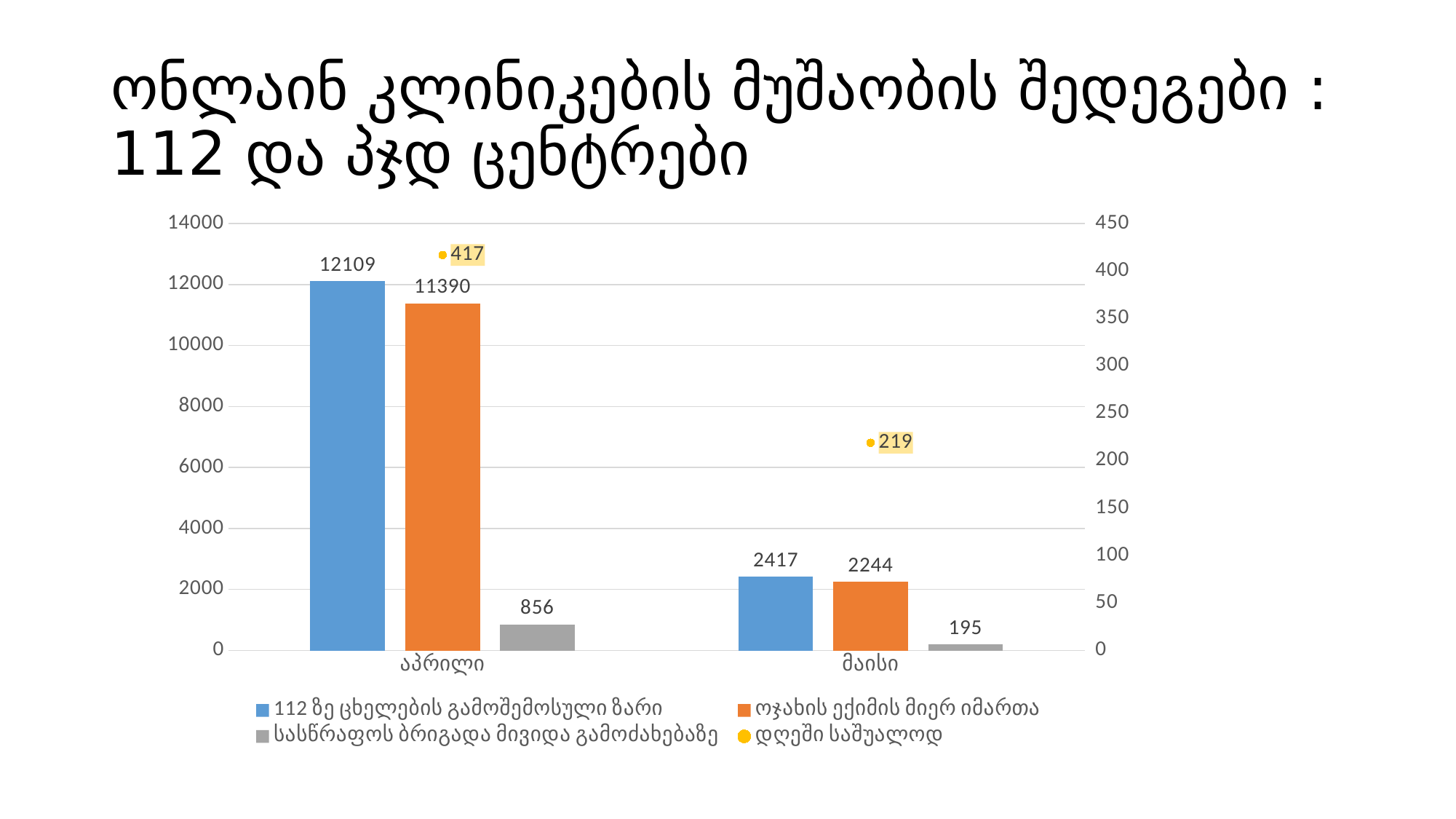
What is the value of the gray series (სასწრაფოს ბრიგადა მივიდა გამოძახებაზე) for აპრილი? 856 Which category has the lowest value for the gray series (სასწრაფოს ბრიგადა მივიდა გამოძახებაზე)? მაისი Which category has the higher value for the blue series (112 ზე ცხელების გამოშემოსული ზარი)? აპრილი What is the difference between the blue series values for აპრილი and მაისი? 9692 How many categories are shown on the x axis? 2 What is the value of the orange series (ოჯახის ექიმის მიერ იმართა) for მაისი? 2244 How many series does the legend list? 4 What is the value of the blue series (112 ზე ცხელების გამოშემოსული ზარი) for აპრილი? 12109 What is the difference between the yellow marker values (დღეში საშუალოდ) for აპრილი and მაისი? 198 What is the value of the yellow marker series (დღეში საშუალოდ) for მაისი? 219 For აპრილი, which is larger: the blue series value or the orange series value? the blue series (12109) Do the values of the orange series (ოჯახის ექიმის მიერ იმართა) rise or fall from აპრილი to მაისი? fall